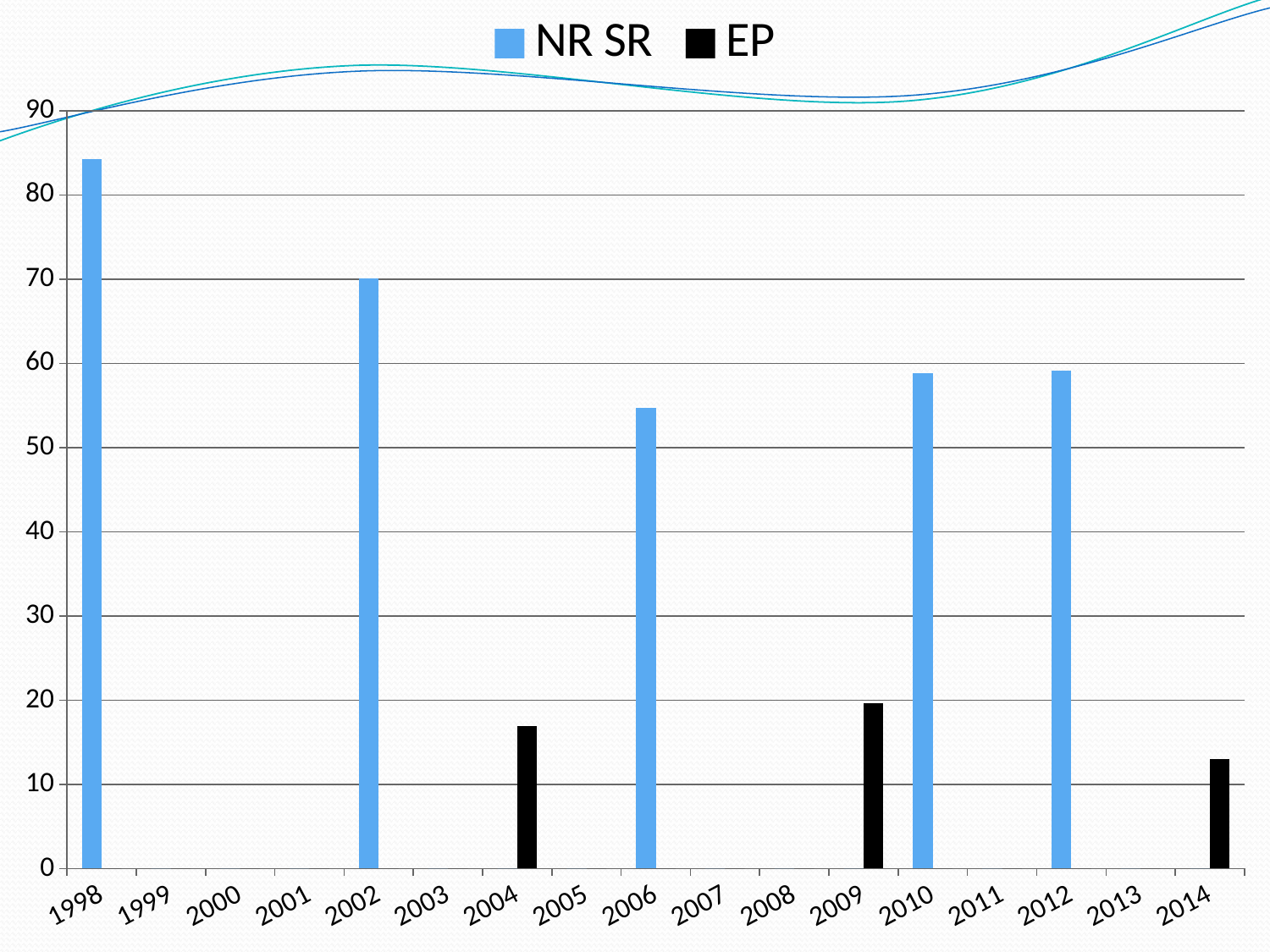
In which year is the EP value highest? 2009 How many years are shown on the x axis? 17 Which is larger, the NR SR value for 1998 or the NR SR value for 2006? 1998 What kind of chart is shown on the slide? bar chart In which year is the NR SR value highest? 1998 Is the NR SR value for 1998 greater or less than 80? greater How many series does the legend list? 2 In which year is the EP value lowest among the years with an EP bar? 2014 In which year is the NR SR value lowest among the years with an NR SR bar? 2006 What are the two series named in the legend? NR SR and EP